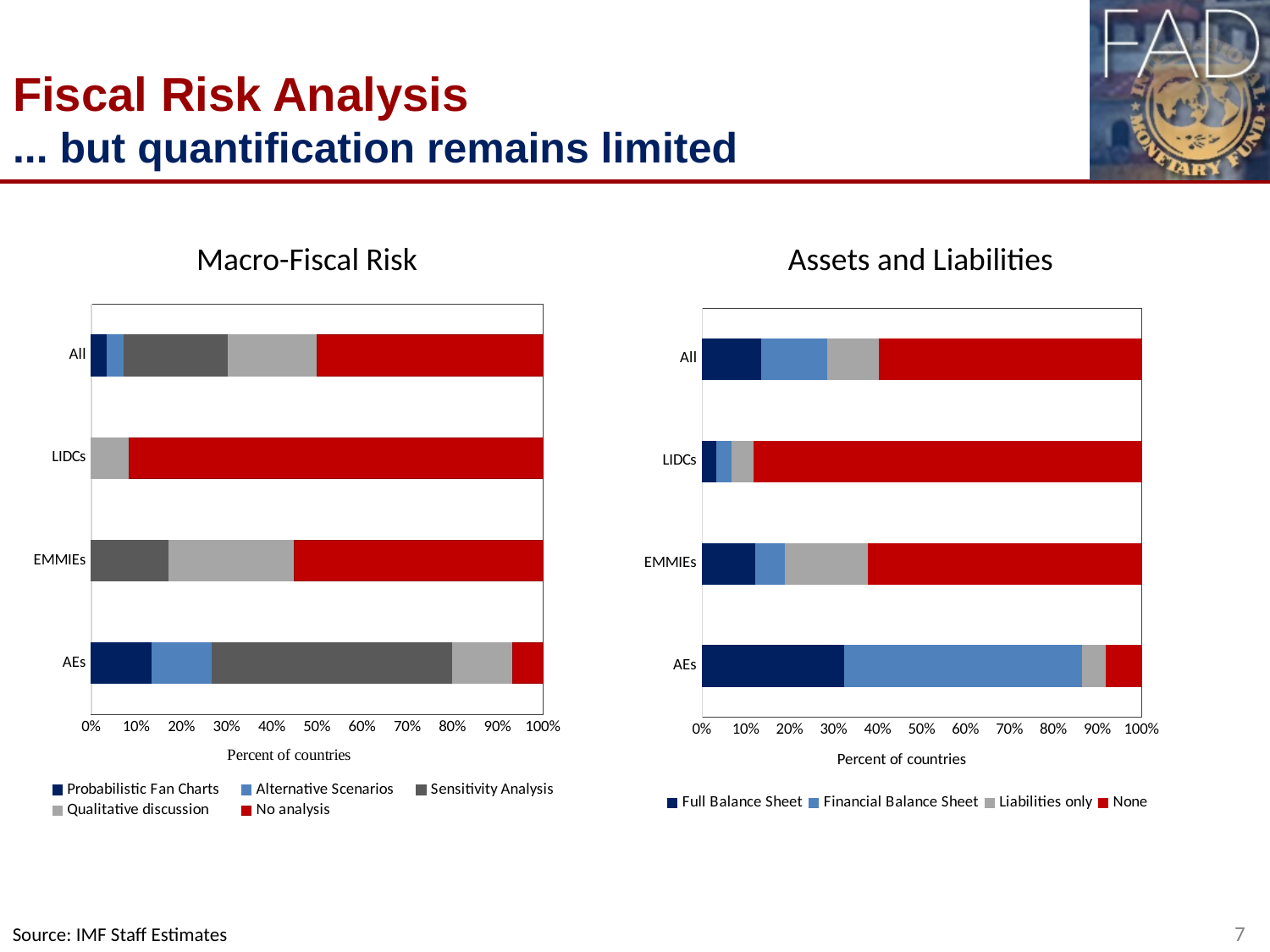
In the Macro-Fiscal Risk chart, which category has the largest No analysis share? LIDCs What kind of chart is the Macro-Fiscal Risk chart? Stacked bar chart In the Macro-Fiscal Risk chart, is the Sensitivity Analysis share larger for AEs or for EMMIEs? AEs How many categories are shown on the y axis of the Assets and Liabilities chart? 4 In the Assets and Liabilities chart, which category has the largest Full Balance Sheet share? AEs In the Assets and Liabilities chart, is the None share for LIDCs greater or less than 80%? greater How many series does the legend of the Macro-Fiscal Risk chart list? 5 In the Macro-Fiscal Risk chart, is the No analysis share for AEs greater or less than 10%? less In the Macro-Fiscal Risk chart, is the No analysis share for LIDCs greater or less than 80%? greater How many series does the legend of the Assets and Liabilities chart list? 4 What is the x-axis label of the Assets and Liabilities chart? Percent of countries